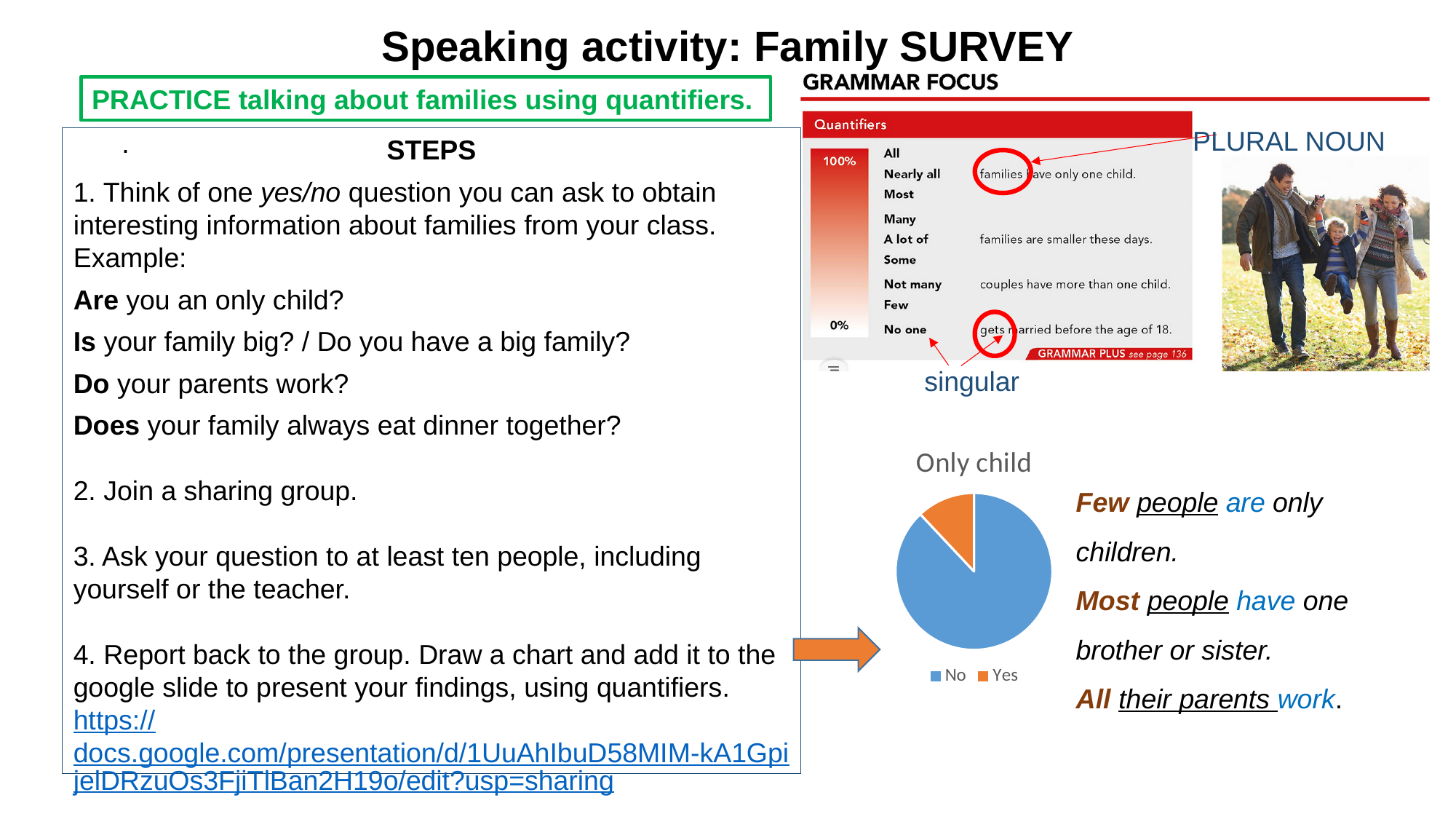
How many categories does the legend of the pie chart list? 2 What is the title of the pie chart? Only child What colour is the Yes slice in the pie chart? orange In the pie chart, which slice is larger, No or Yes? No Which category has the largest slice in the pie chart? No What kind of chart is shown on the slide? pie chart Which category has the smallest slice in the pie chart? Yes How many slices does the pie chart have? 2